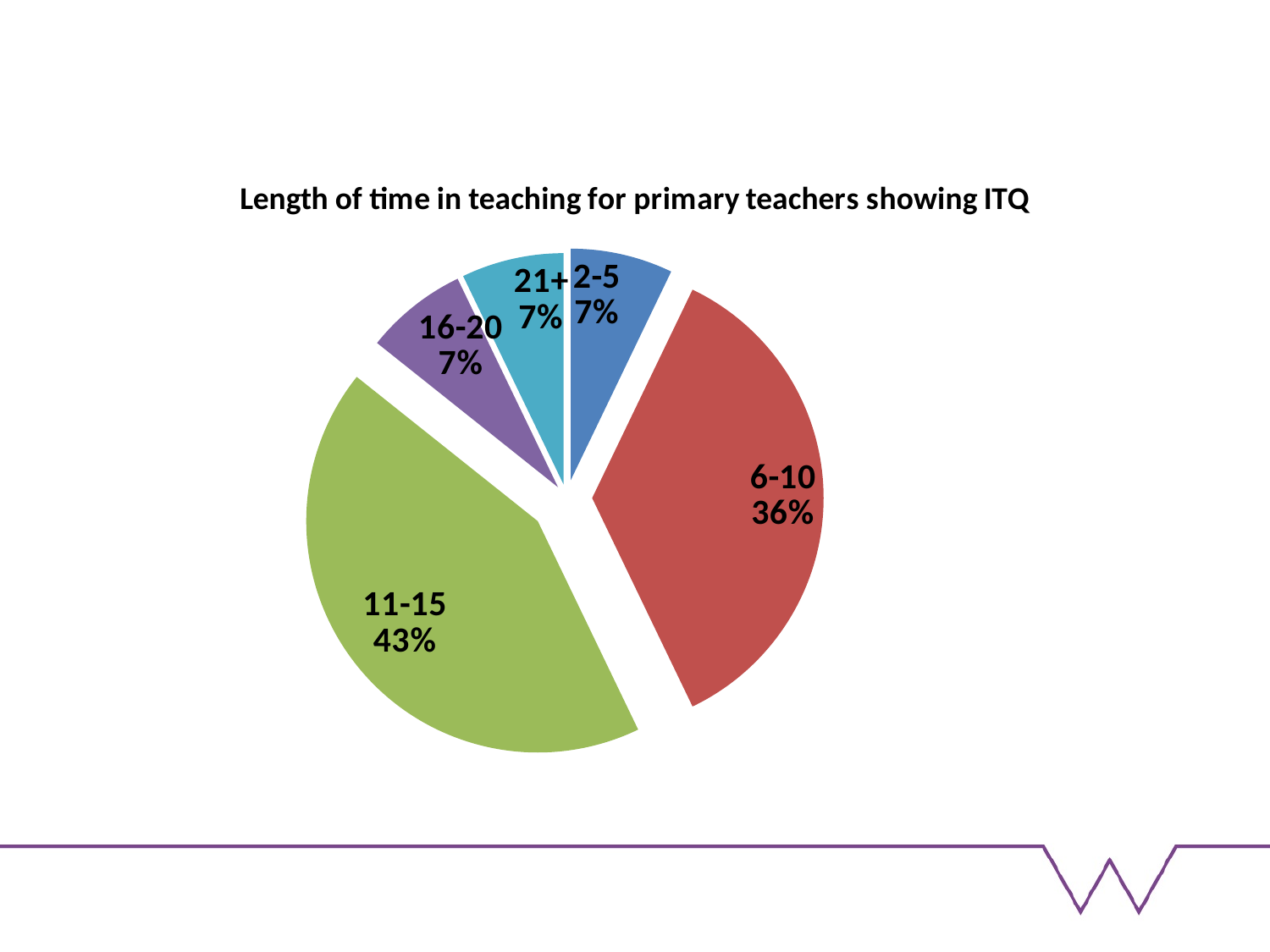
What is the combined share of the 2-5, 16-20 and 21+ categories? 21% What percentage is shown for the 2-5 years category? 7% What is the title of the chart? Length of time in teaching for primary teachers showing ITQ What percentage is shown for the 21+ years category? 7% What colour is the slice for the 11-15 category? green What type of chart is shown on the slide? pie chart What is the difference in percentage points between the 11-15 and 6-10 categories? 7 What percentage is shown for the 6-10 years category? 36% What percentage of primary teachers showing ITQ have been teaching 11-15 years? 43% Which category has the largest share of the pie? 11-15 How many categories (slices) does the pie chart have? 5 Which is larger, the share for 6-10 years or the share for 16-20 years? 6-10